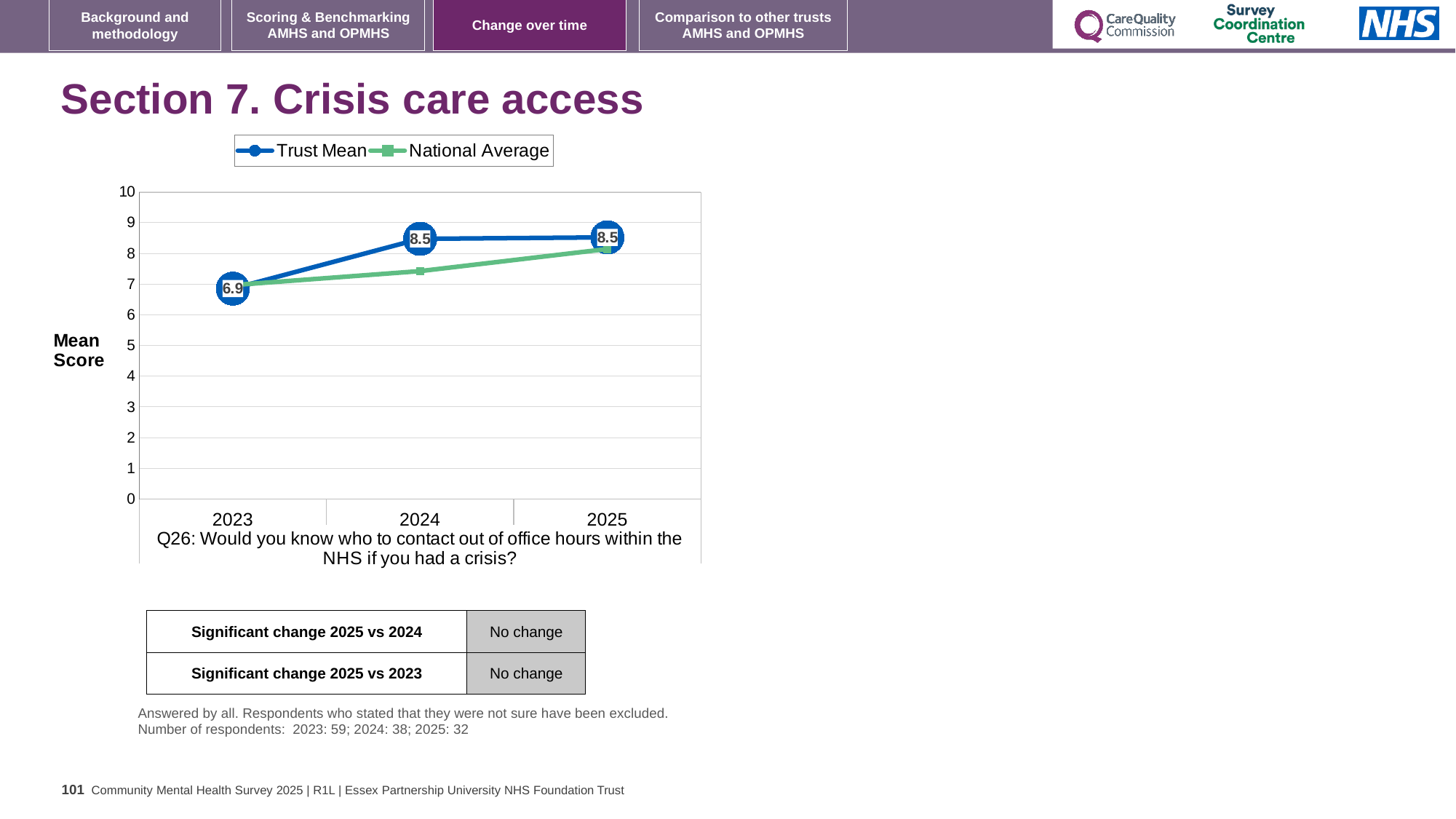
Is the National Average value for 2024 greater or less than 8? less Is the National Average value for 2025 greater or less than 7? greater What kind of chart is shown on the slide? line chart In which year is the Trust Mean score lowest? 2023 Does the Trust Mean score rise or fall from 2023 to 2025? rise By how much did the Trust Mean score increase from 2023 to 2024? 1.6 Which is larger in 2024, the Trust Mean or the National Average? Trust Mean How many years are shown on the x axis of the chart? 3 What is the Trust Mean score for 2025? 8.5 How many series does the chart legend list? 2 What is the Trust Mean score for 2023? 6.9 What is the Trust Mean score for 2024? 8.5